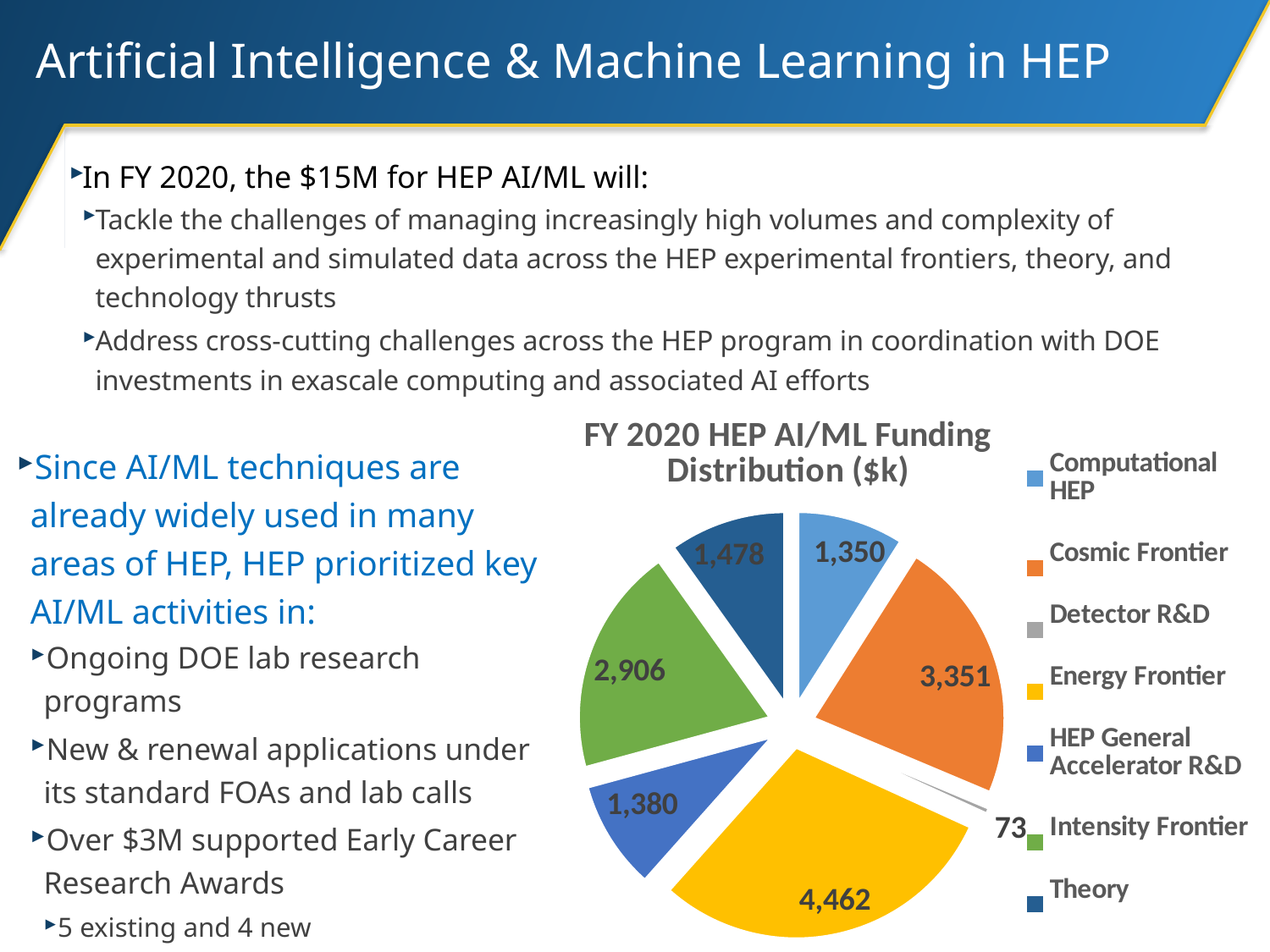
What type of chart is shown on the slide? Pie chart What is the funding value for Detector R&D? 73 Which category receives the largest share of funding? Energy Frontier How many categories does the legend of the pie chart list? 7 What colour is the Intensity Frontier slice? Green Which has a larger funding value, Computational HEP or HEP General Accelerator R&D? HEP General Accelerator R&D What is the funding value for Cosmic Frontier? 3,351 What is the title of the chart? FY 2020 HEP AI/ML Funding Distribution ($k) What is the funding value for Energy Frontier? 4,462 What is the funding value for Theory? 1,478 What is the difference between the Energy Frontier and Intensity Frontier funding values? 1,556 Which category receives the smallest share of funding? Detector R&D